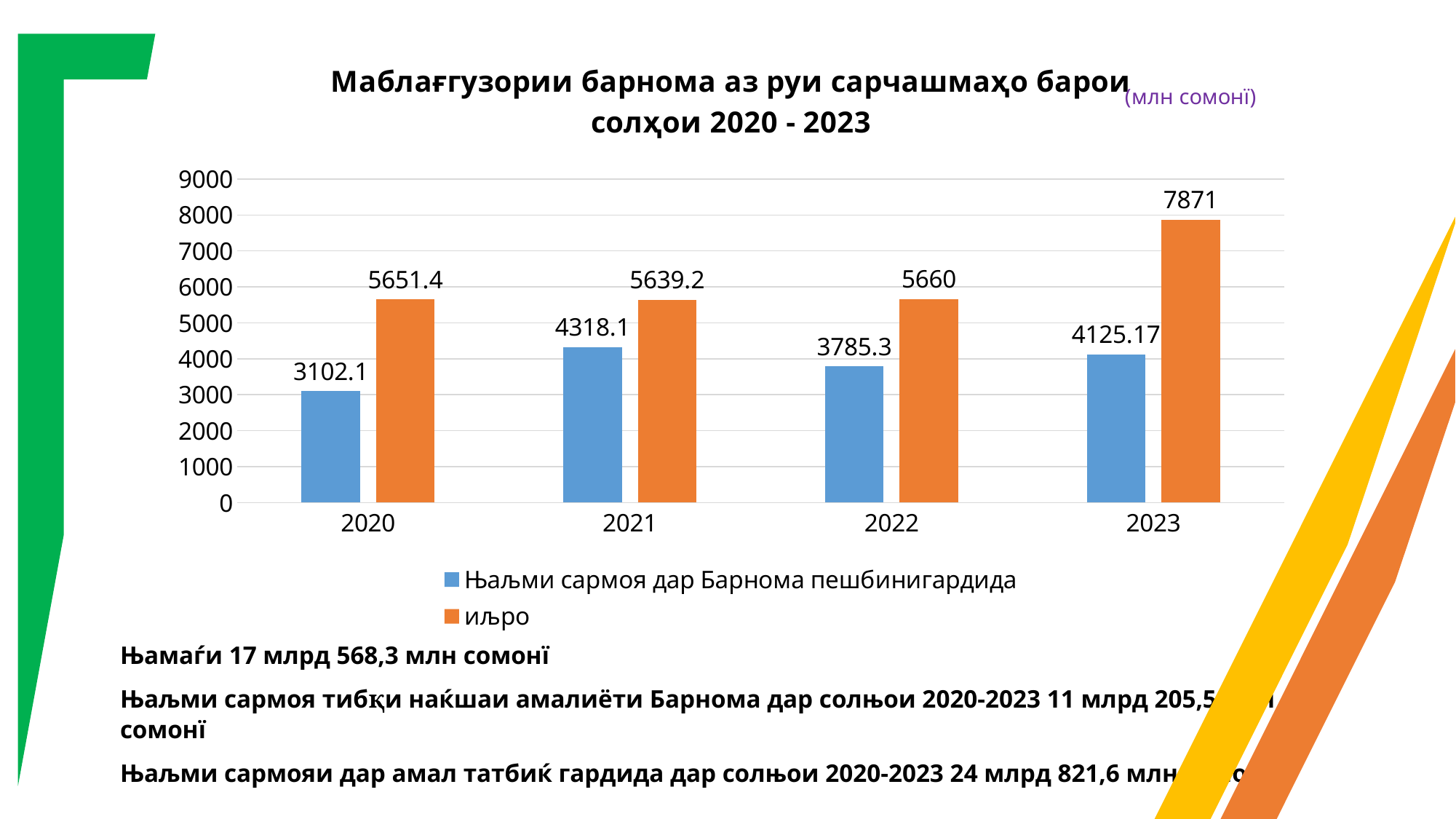
In which year is the "Њаљми сармоя дар Барнома пешбинигардида" value lowest? 2020 Which is larger in 2021: the "иљро" value or the "Њаљми сармоя дар Барнома пешбинигардида" value? иљро What unit is indicated next to the chart title? млн сомонї What is the value of the "иљро" series for 2023? 7871 How many series does the legend list? 2 What is the value of the "иљро" series for 2022? 5660 In which year is the "иљро" value highest? 2023 How many years are shown on the x axis? 4 What type of chart is shown on the slide? bar chart Is the "иљро" value for 2023 greater or less than 7000? greater What is the difference between the "иљро" value and the "Њаљми сармоя дар Барнома пешбинигардида" value in 2023? 3745.83 What is the value of the "Њаљми сармоя дар Барнома пешбинигардида" series for 2020? 3102.1